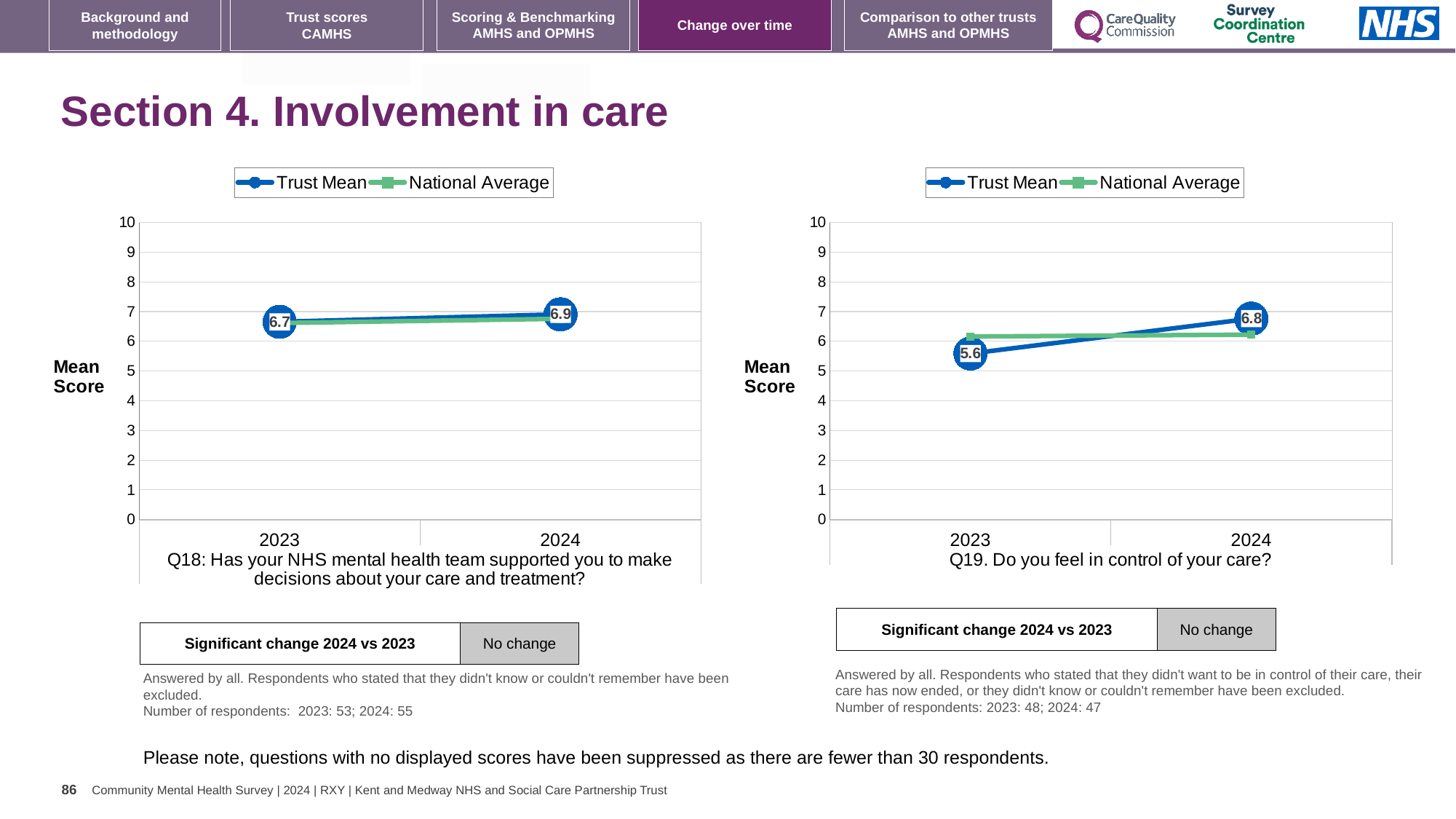
On the Q19 chart, in 2023 which is higher, the Trust Mean or the National Average? National Average On the Q18 chart, what is the Trust Mean score for 2023? 6.7 On the Q18 chart, what is the Trust Mean score for 2024? 6.9 On the Q19 chart, by how much did the Trust Mean change from 2023 to 2024? 1.2 What type of chart is used for Q19? line chart On the Q19 chart, is the National Average for 2024 greater or less than 7? less On the Q19 chart, does the Trust Mean rise or fall from 2023 to 2024? rise On the Q19 chart, what is the Trust Mean score for 2023? 5.6 How many years are plotted on the x axis of the Q18 chart? 2 On the Q18 chart, what is the difference between the Trust Mean in 2024 and 2023? 0.2 How many series does the legend of the Q18 chart list? 2 On the Q19 chart, what is the Trust Mean score for 2024? 6.8